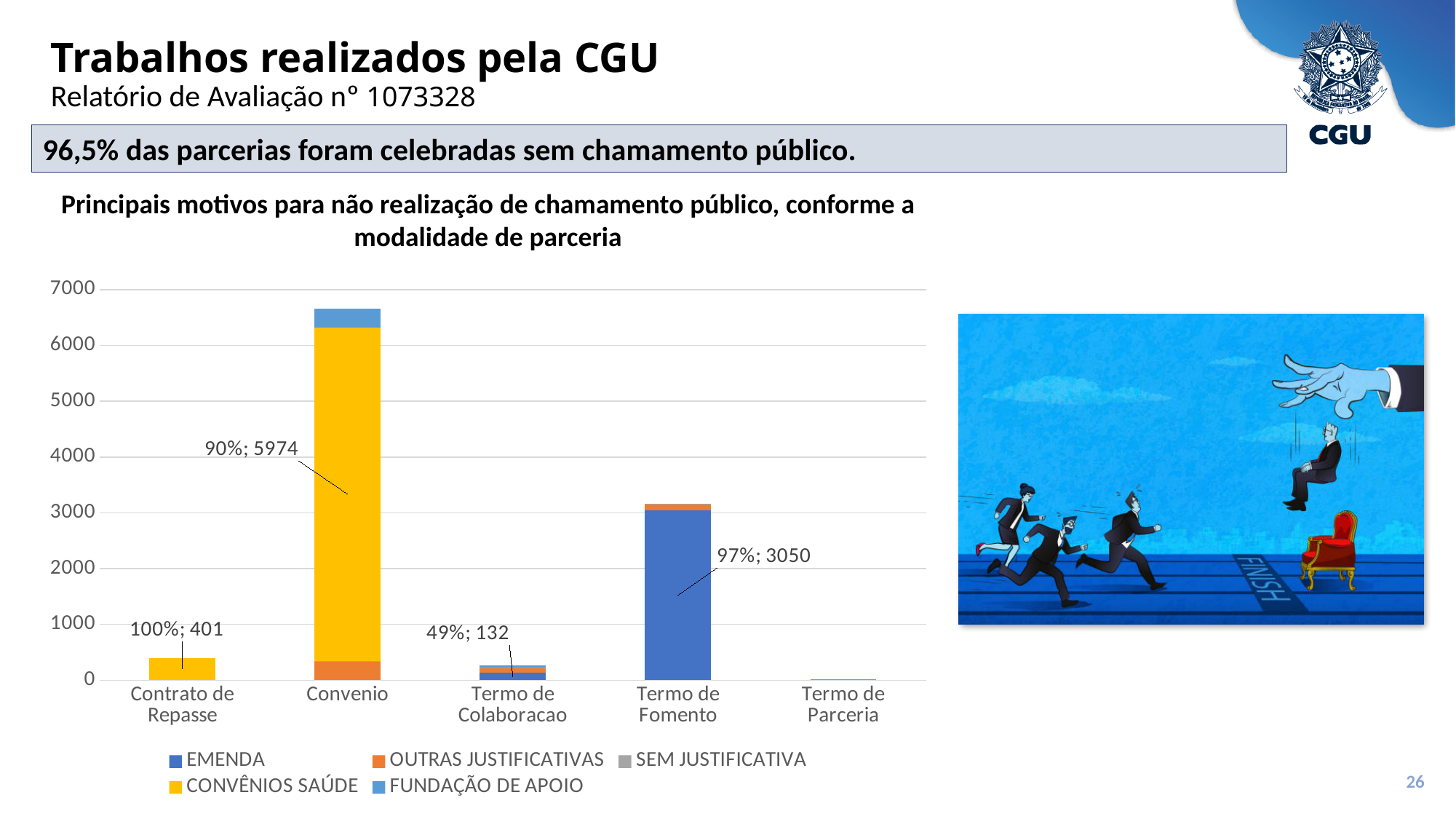
How many partnership modalities (categories) are shown on the x axis? 5 What value is labelled for EMENDA in the Termo de Fomento bar? 3050 How many series does the legend list? 5 What value is labelled on the Contrato de Repasse bar? 401 What kind of chart is shown on the slide? bar chart Which category has the tallest stacked bar? Convenio What value is labelled for CONVÊNIOS SAÚDE in the Convenio bar? 5974 What percentage is shown in the data label for Termo de Colaboracao? 49% Which series is shown in yellow in the legend? CONVÊNIOS SAÚDE Is the total for Termo de Fomento greater or less than 3000? greater Which category has the shortest stacked bar? Termo de Parceria What is the difference between the labelled value for Convenio (5974) and the labelled value for Termo de Fomento (3050)? 2924